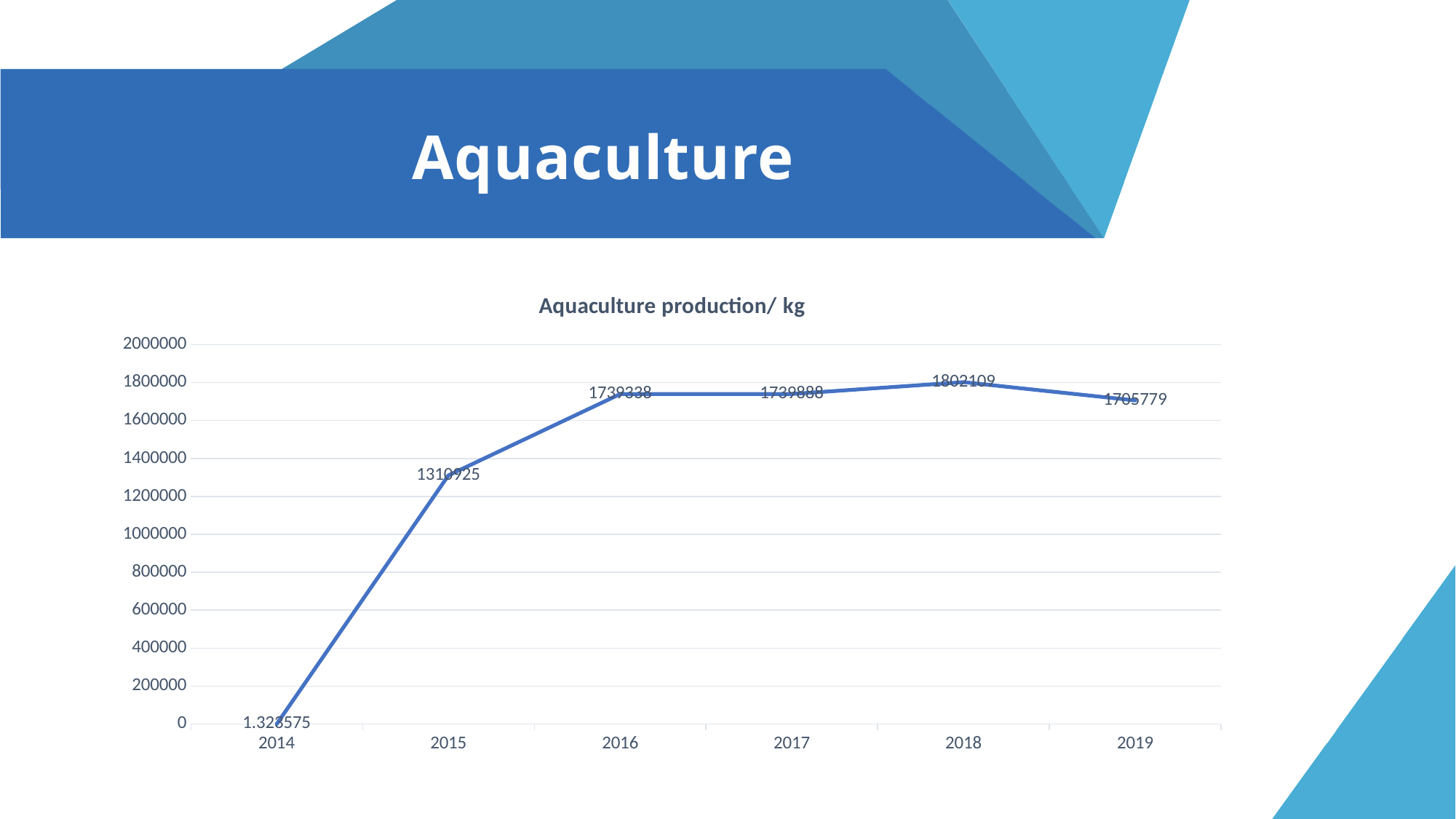
What is the aquaculture production value shown for 2019? 1705779 How many years are plotted on the chart? 6 Which year has the lowest aquaculture production? 2014 What is the aquaculture production value shown for 2018? 1802109 What is the aquaculture production value shown for 2015? 1310925 Which year has the larger aquaculture production, 2015 or 2016? 2016 What is the title of the chart? Aquaculture production/ kg Which year has the highest aquaculture production? 2018 What is the difference between the 2018 and 2019 aquaculture production values? 96330 What kind of chart is shown on the slide? line chart Is the aquaculture production value for 2015 greater or less than 1200000? greater What value is labelled for 2014 on the chart? 1.323575